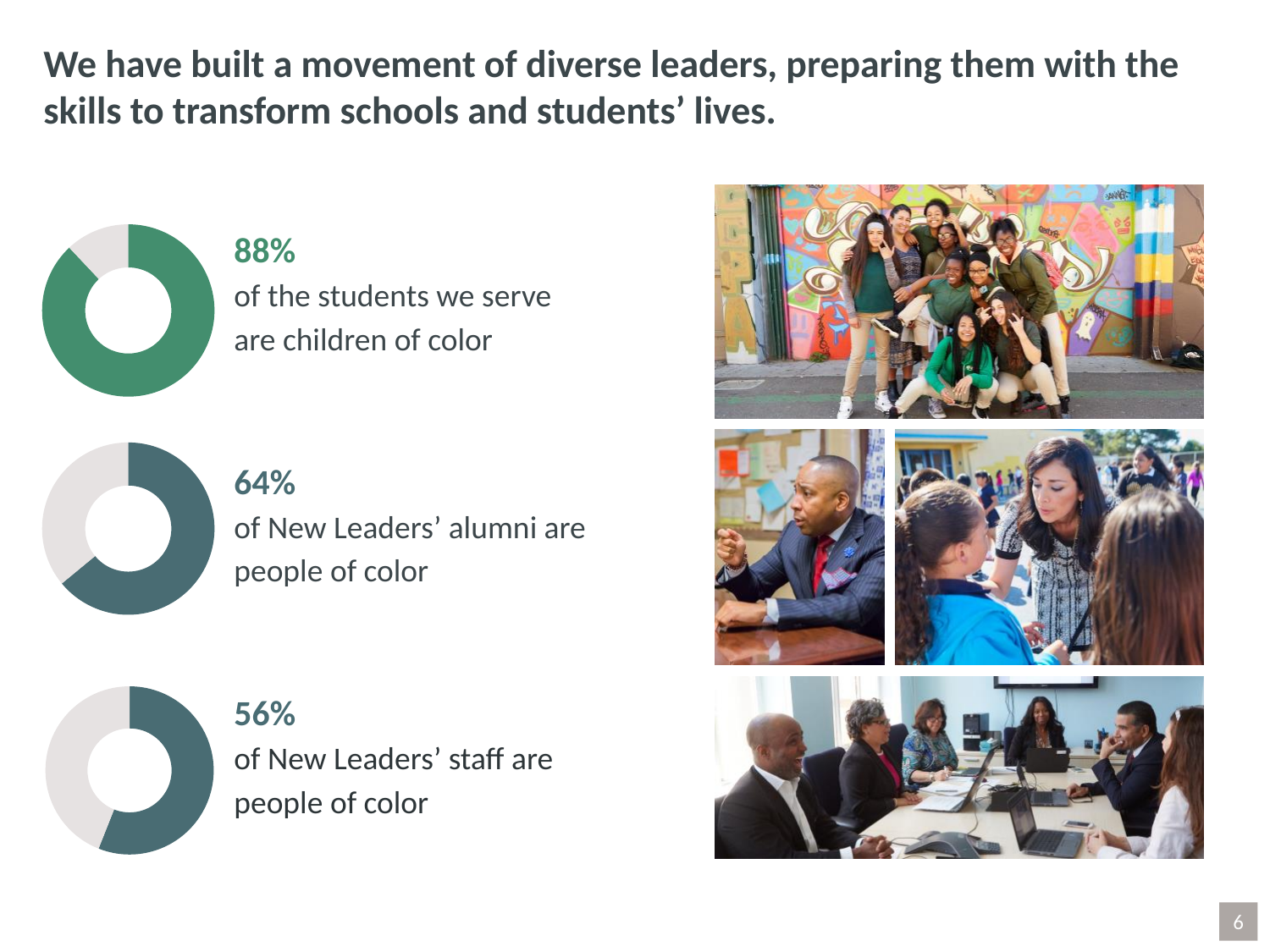
According to the middle donut chart, what percentage of New Leaders' alumni are people of color? 64% How many segments does each donut chart on the slide have? 2 What is the difference between the percentage of students who are children of color and the percentage of alumni who are people of color? 24 percentage points What kind of chart is used to show the 88% figure for students who are children of color? Donut chart What percentage of the students served are children of color, according to the top donut chart? 88% According to the bottom donut chart, what percentage of New Leaders' staff are people of color? 56% How many donut charts are shown on the slide? 3 Which of the three donut charts shows the highest percentage: students, alumni, or staff? Students (88%) In the top donut chart, what share of the ring is not filled by the green segment (i.e., students who are not children of color)? 12% Is the percentage of New Leaders' alumni who are people of color larger or smaller than the percentage of staff who are people of color? Larger What is the difference between the percentage of alumni who are people of color and the percentage of staff who are people of color? 8 percentage points Which of the three donut charts shows the lowest percentage: students, alumni, or staff? Staff (56%)